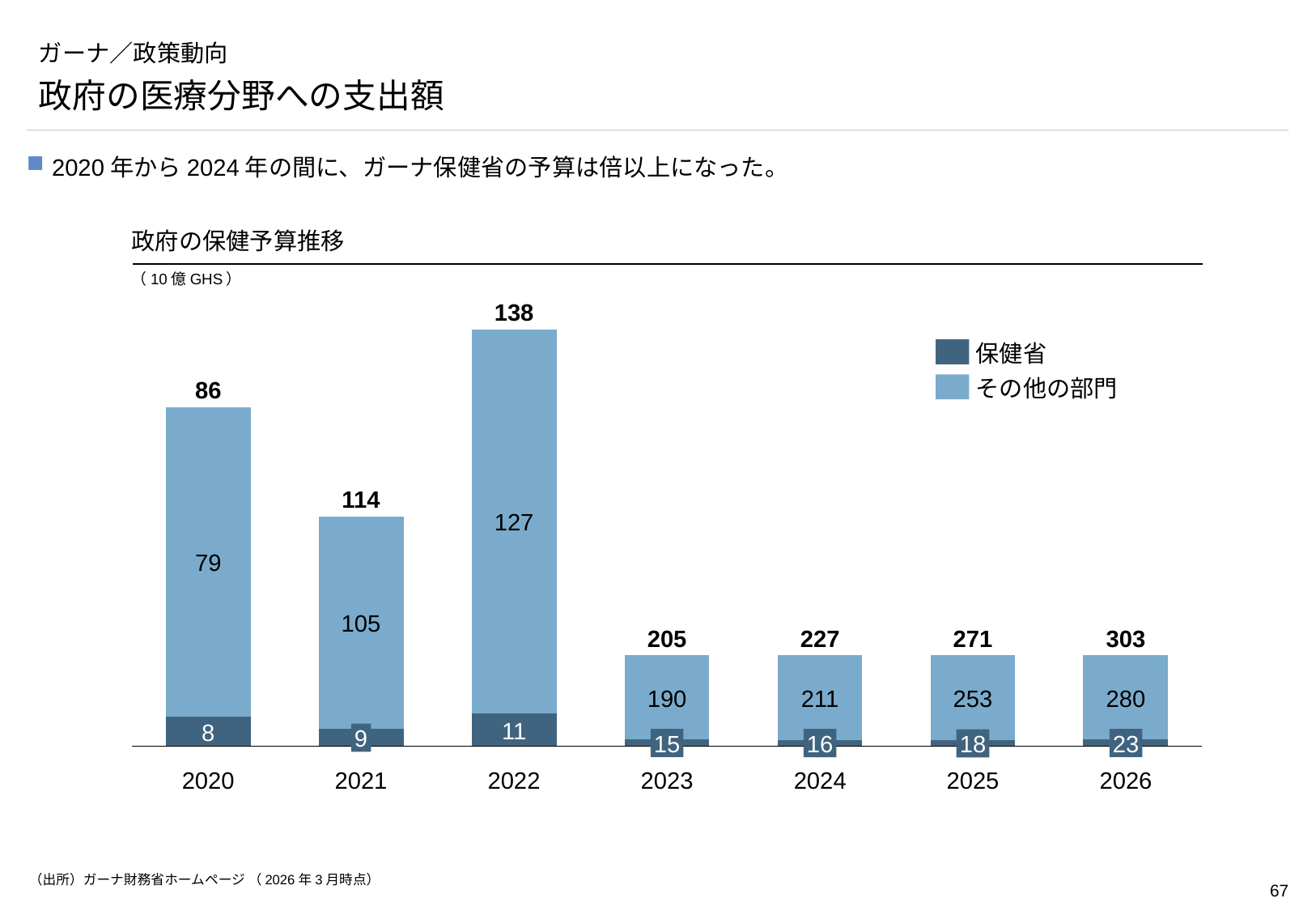
What unit is stated for the chart values? 10億GHS What type of chart is shown on the slide? Stacked bar chart Which year has the lowest value for 保健省? 2020 Which year has the highest total health budget? 2026 What is the total health budget shown for 2020? 86 What is the value for その他の部門 in 2022? 127 How many years are shown on the x axis? 7 What is the value for 保健省 in 2024? 16 What is the difference between the 保健省 values for 2026 and 2020? 15 What is the total health budget shown for 2026? 303 How many series does the legend list? 2 Which is larger, the その他の部門 value for 2021 or for 2023? 2023